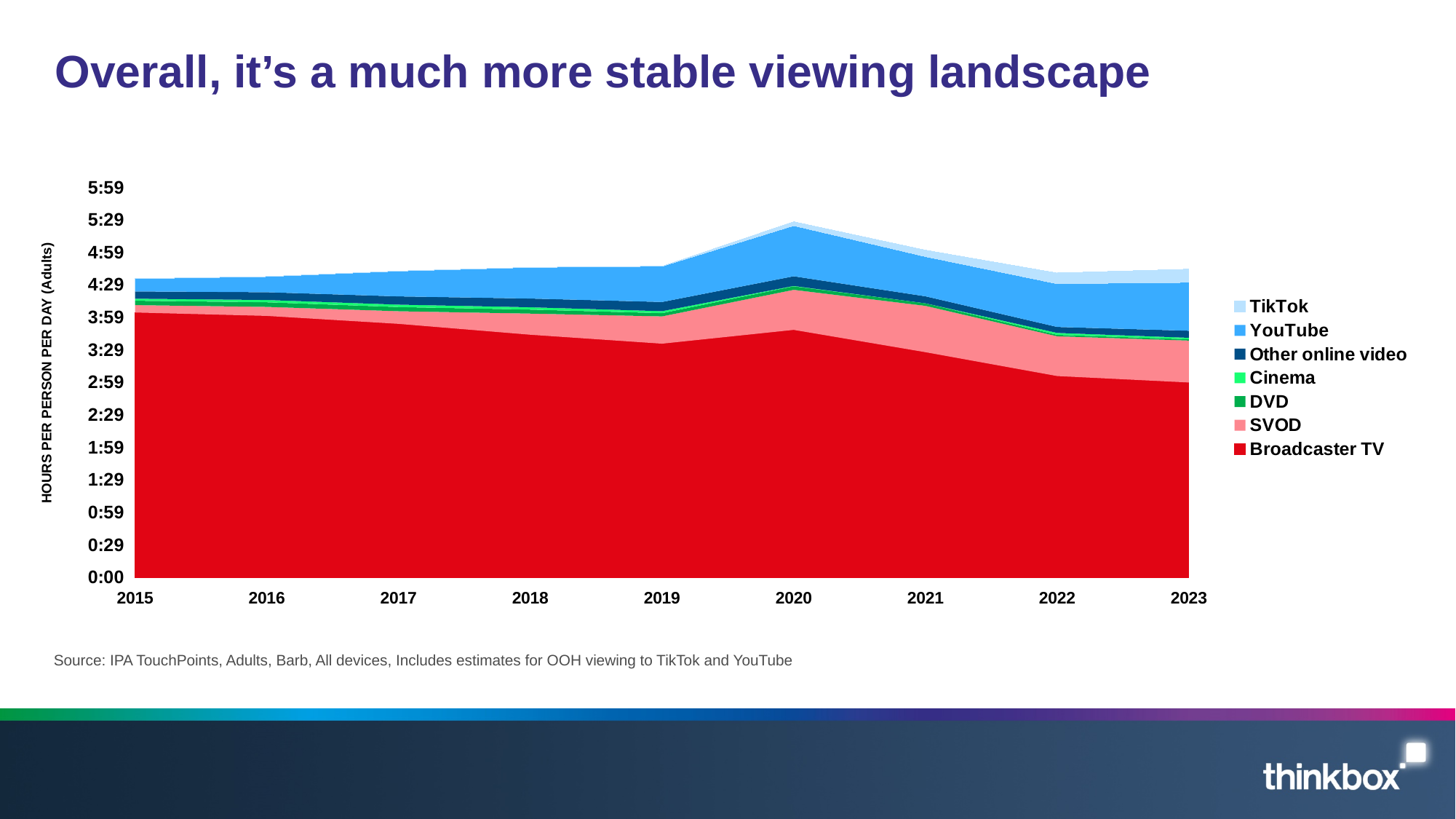
What kind of chart is shown on the slide? Stacked area chart Which year has the highest total hours per person per day? 2020 How many years are shown on the x axis? 9 Which is larger, the Broadcaster TV value in 2015 or in 2023? 2015 How many series does the legend list? 7 Does the Broadcaster TV value rise or fall overall from 2015 to 2023? fall Is the total viewing in 2023 greater or less than 4:59? less What is the label on the y axis? HOURS PER PERSON PER DAY (Adults) Is the total viewing in 2020 greater or less than 4:59? greater Is the Broadcaster TV value in 2020 greater or less than 3:29? greater